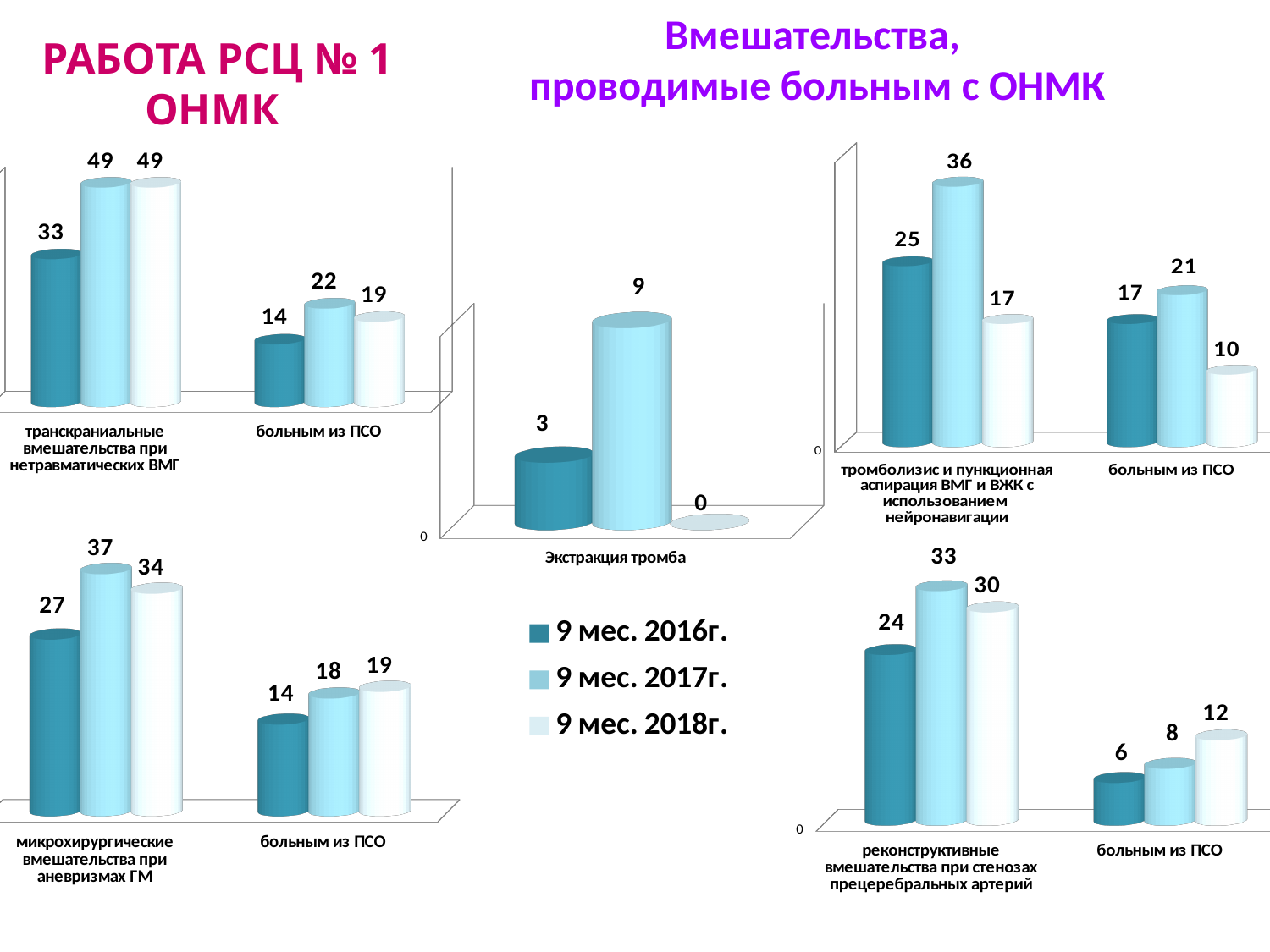
In the center chart (Экстракция тромба), which year has the highest value? 9 мес. 2017г. In the top-right chart, what is the difference between the 9 мес. 2017г. and 9 мес. 2018г. values for тромболизис и пункционная аспирация ВМГ и ВЖК с использованием нейронавигации? 19 How many series does the legend on the slide list? 3 In the top-right chart, which year has the lowest value for больным из ПСО? 9 мес. 2018г. In the bottom-left chart, which is larger for больным из ПСО: the 9 мес. 2016г. value or the 9 мес. 2018г. value? 9 мес. 2018г. In the bottom-right chart, what is the value for 9 мес. 2016г. for реконструктивные вмешательства при стенозах прецеребральных артерий? 24 In the top-left chart, what is the value for 9 мес. 2016г. for больным из ПСО? 14 What kind of chart is the center chart (Экстракция тромба)? bar chart In the top-left chart, what is the value for 9 мес. 2017г. for транскраниальные вмешательства при нетравматических ВМГ? 49 In the bottom-left chart, what is the value for 9 мес. 2018г. for микрохирургические вмешательства при аневризмах ГМ? 34 In the bottom-right chart, do the values for больным из ПСО rise or fall from 2016 to 2018? rise In the center chart (Экстракция тромба), what is the value for 9 мес. 2018г.? 0